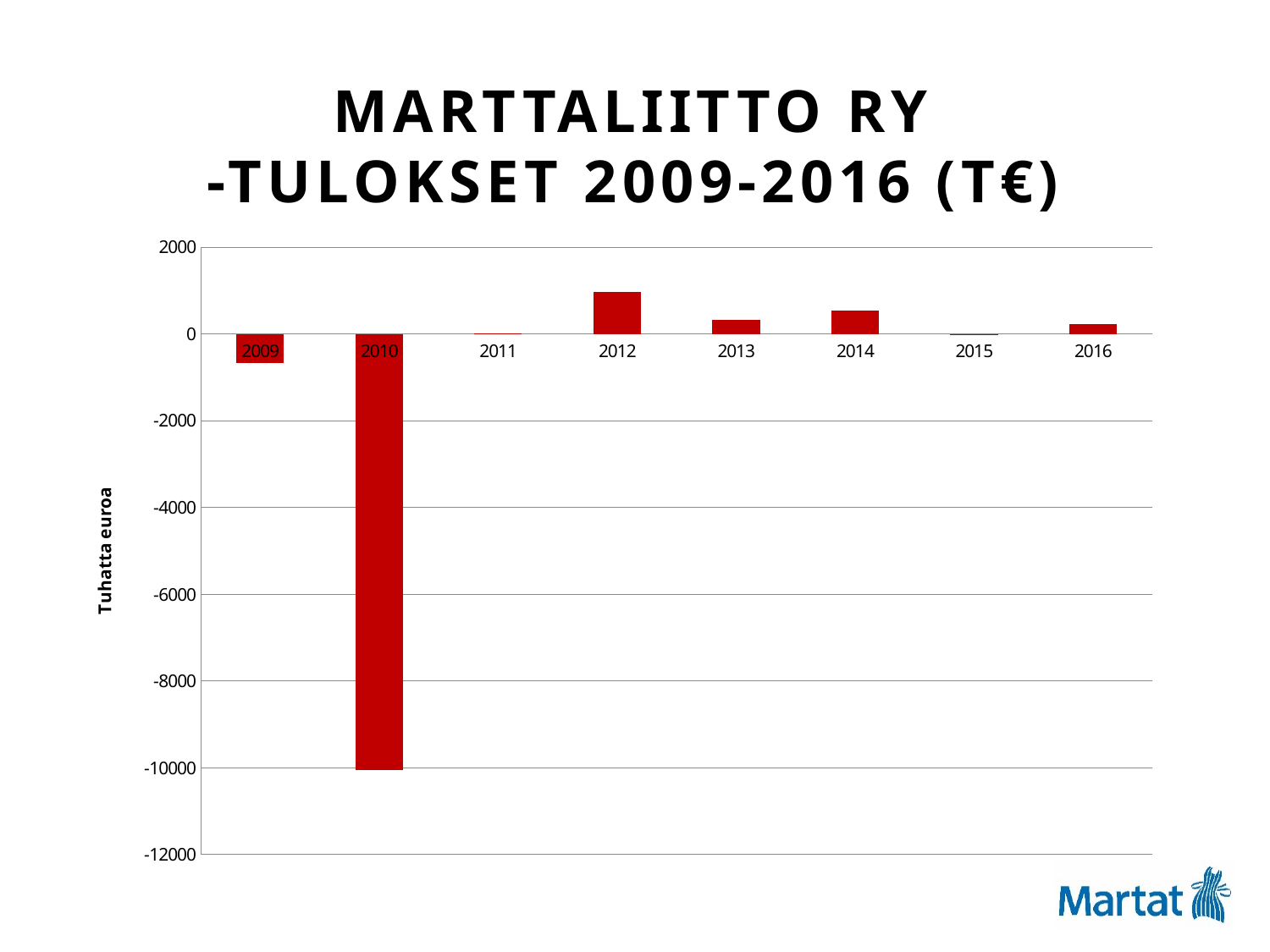
Is the value for 2009 greater or less than -2000? greater What is the label on the vertical axis of the chart? Tuhatta euroa Which year has the highest value in the chart? 2012 Which year has the larger value, 2014 or 2016? 2014 What kind of chart is shown on the slide? bar chart Which year has the larger value, 2012 or 2013? 2012 Is the value for 2010 greater or less than -8000? less What is the title of the slide containing the chart? MARTTALIITTO RY -TULOKSET 2009-2016 (T€) How many years are plotted on the x axis of the chart? 8 Is the value for 2014 greater or less than 0? greater Which year has the lowest value in the chart? 2010